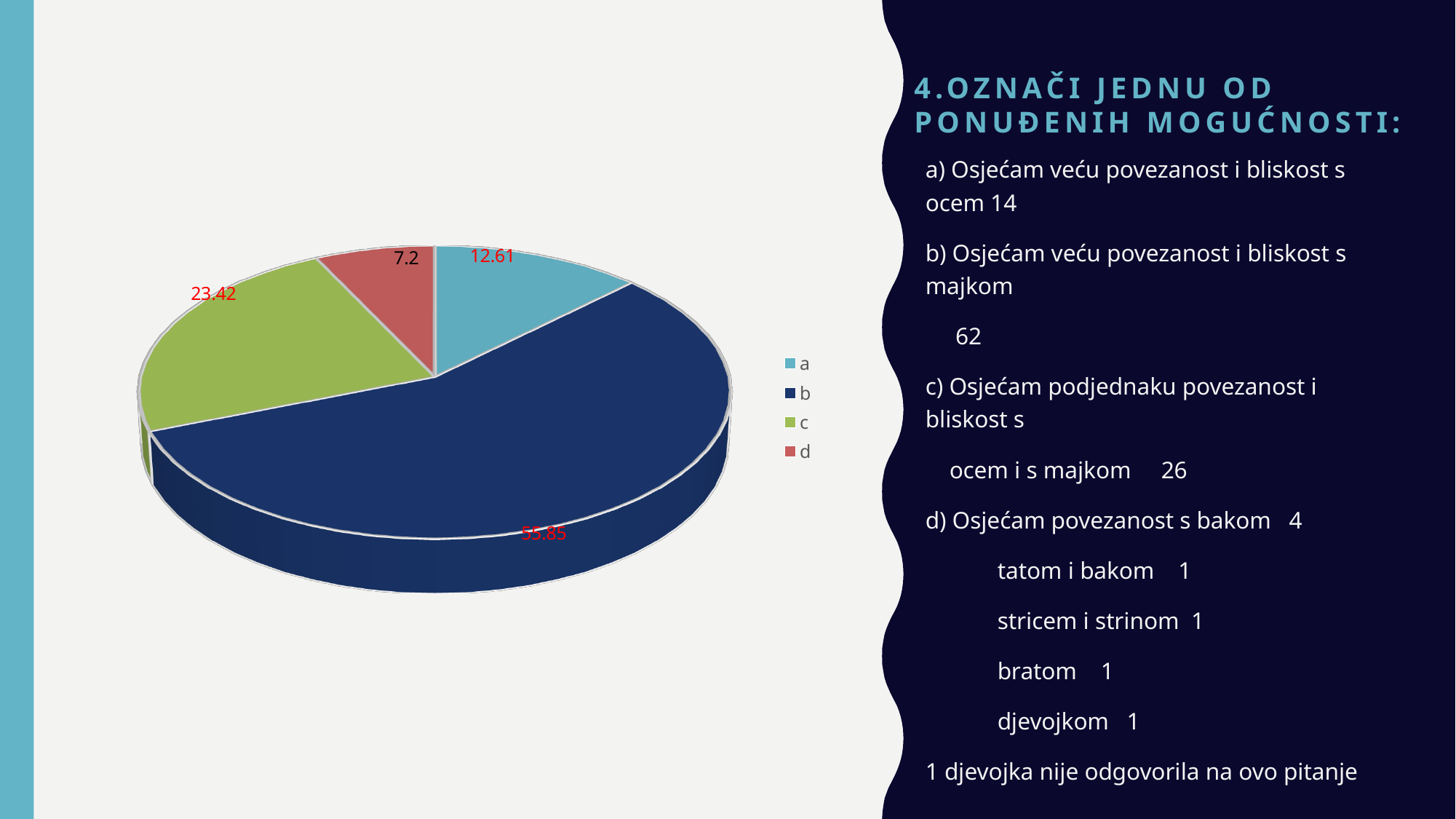
What is the value shown for slice c in the pie chart? 23.42 What is the value shown for slice b in the pie chart? 55.85 Which slice of the pie chart is the smallest? d Which slice of the pie chart is the largest? b Which is larger in the pie chart, slice a or slice c? c What is the value shown for slice a in the pie chart? 12.61 What is the difference between the values for slices b and c in the pie chart? 32.43 What type of chart is shown on the slide? pie chart What is the difference between the values for slices a and d in the pie chart? 5.41 How many entries does the legend of the pie chart list? 4 How many slices does the pie chart have? 4 What is the value shown for slice d in the pie chart? 7.2